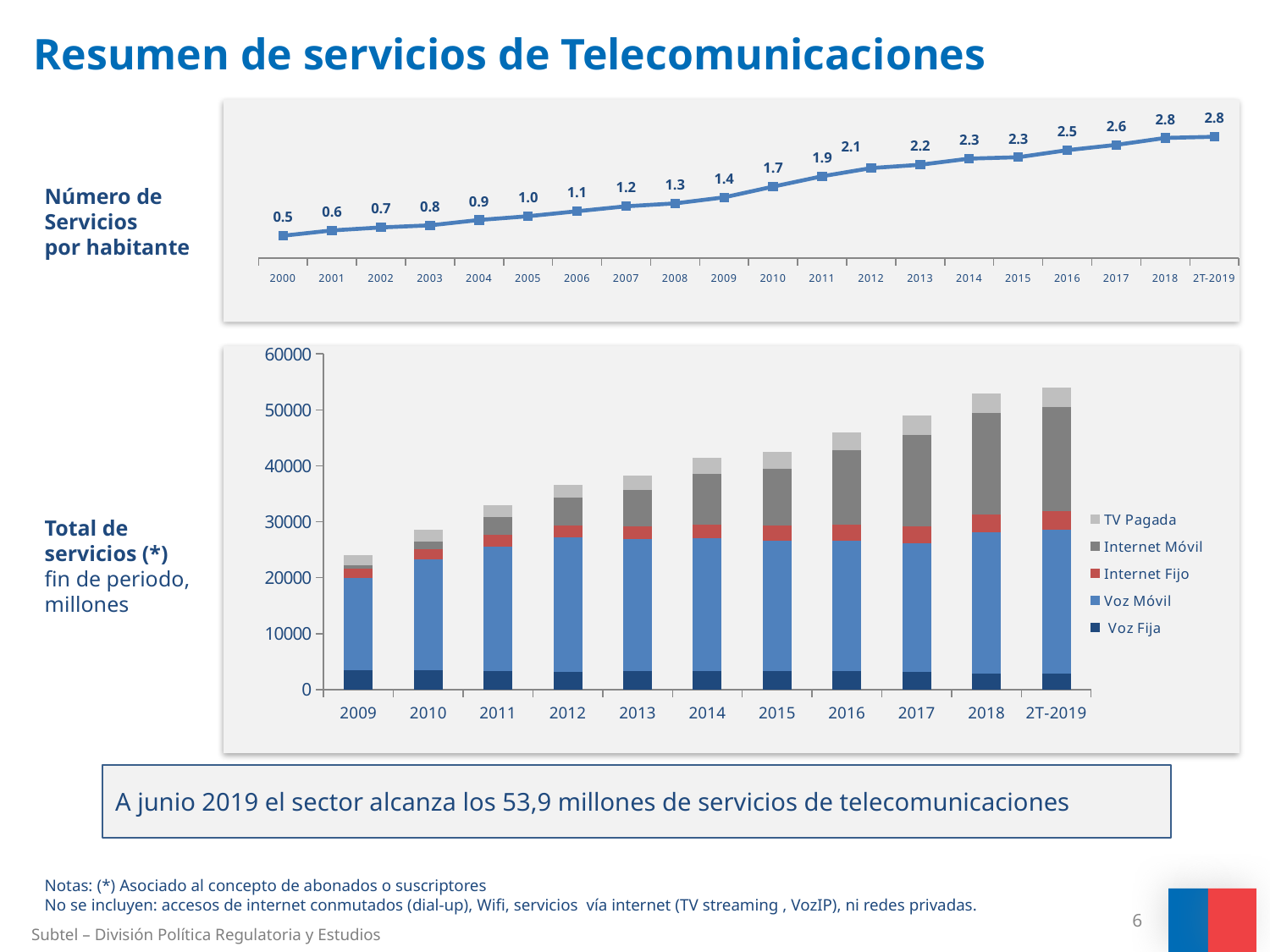
In the 'Número de Servicios por habitante' chart, what is the value for 2T-2019? 2.8 In the 'Número de Servicios por habitante' chart, what is the difference between the values for 2018 and 2009? 1.4 In the 'Número de Servicios por habitante' chart, what is the value for 2000? 0.5 How many data points are plotted in the 'Número de Servicios por habitante' chart? 20 In the 'Número de Servicios por habitante' chart, which year has the lowest value? 2000 How many series does the legend of the 'Total de servicios' chart list? 5 In the 'Número de Servicios por habitante' chart, what is the value for 2010? 1.7 In the 'Total de servicios' chart, is the total for 2009 greater or less than 30000? less In the 'Número de Servicios por habitante' chart, do the values rise or fall from 2000 to 2T-2019? rise How many years (categories) are shown on the x axis of the 'Total de servicios' chart? 11 In the 'Total de servicios' chart, which series is shown at the bottom of each stacked bar? Voz Fija What kind of chart is the 'Total de servicios' chart at the bottom of the slide? stacked bar chart